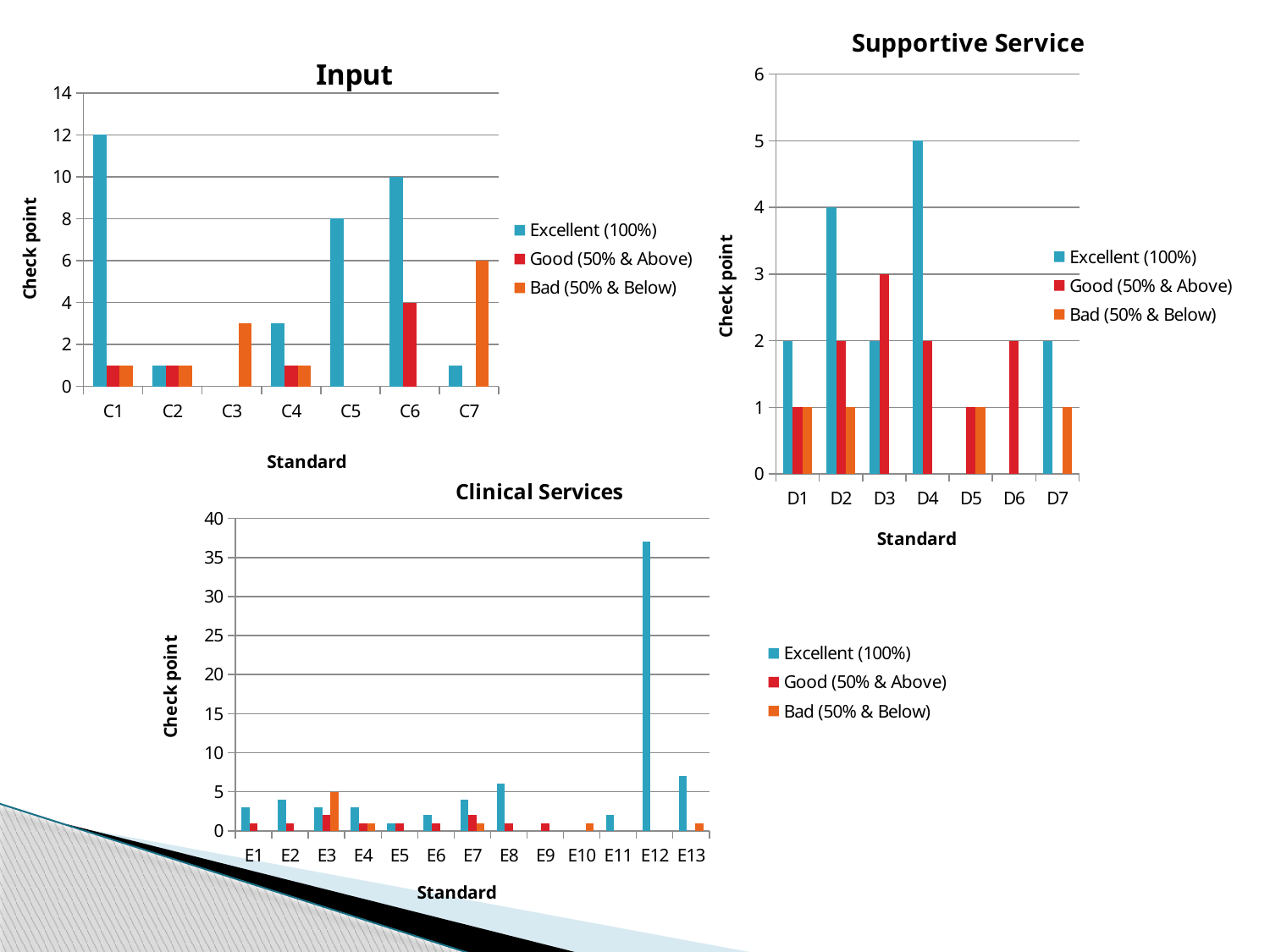
In the Supportive Service chart, what is the difference between the Excellent (100%) values for D4 and D2? 1 In the Clinical Services chart, how many series does the legend list? 3 In the Clinical Services chart, which standard has the highest Excellent (100%) value? E12 In the Input chart, how many standards are shown on the x axis? 7 In the Input chart, what is the Excellent (100%) value for C1? 12 In the Input chart, what is the Bad (50% & Below) value for C7? 6 In the Clinical Services chart, is the Excellent (100%) value for E12 greater or less than 35? greater What kind of chart is the Clinical Services chart? Bar chart In the Supportive Service chart, what is the Excellent (100%) value for D4? 5 In the Supportive Service chart, which standard has the highest Excellent (100%) value? D4 In the Input chart, which standard has the highest Excellent (100%) value? C1 In the Supportive Service chart, what is the Good (50% & Above) value for D3? 3